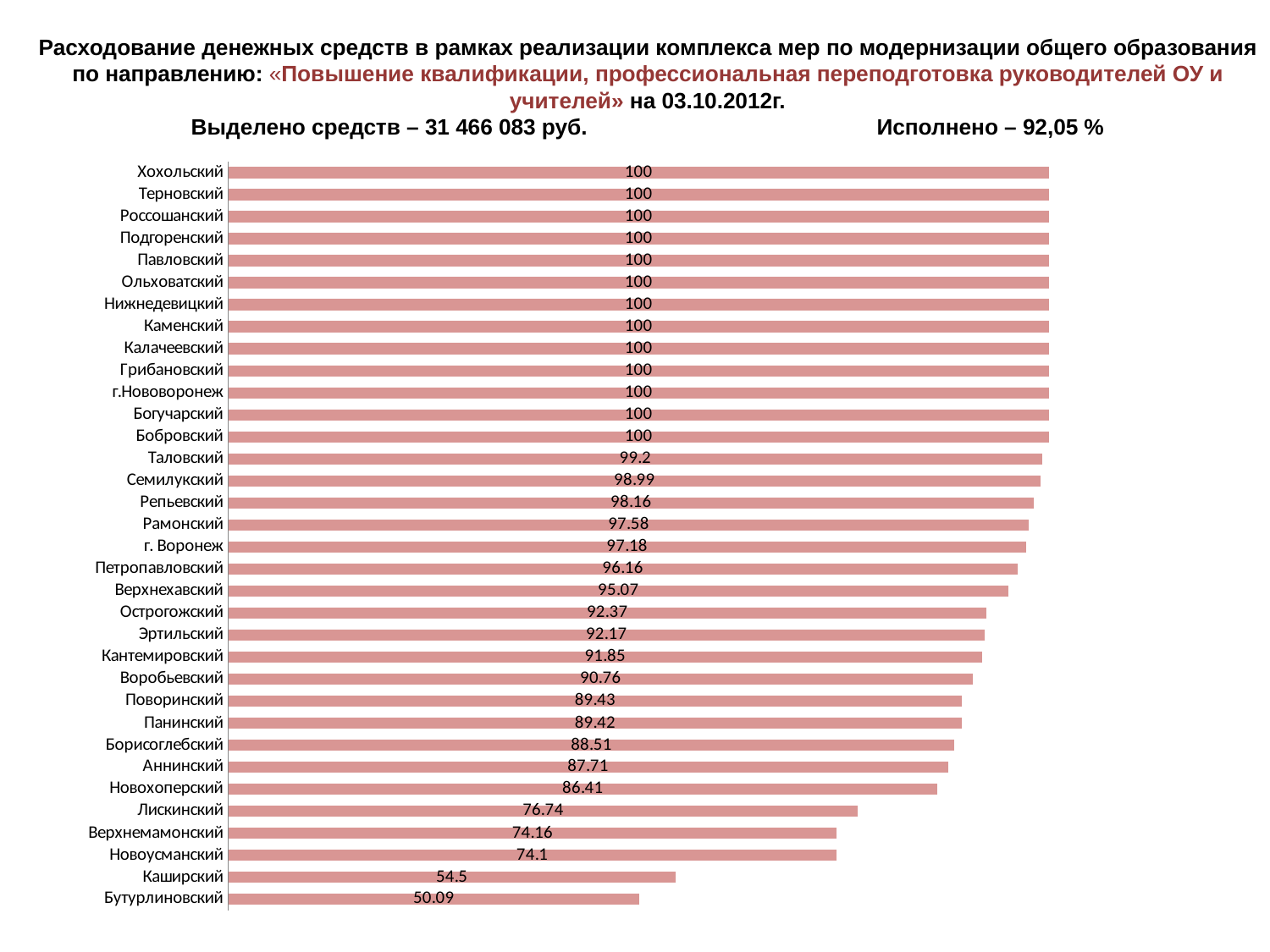
Which is larger, the value for Острогожский or the value for Воробьевский? Острогожский What kind of chart is shown on the slide? Bar chart How many categories have a value of 100? 13 What is the value for г. Воронеж? 97.18 What is the difference between the values for Таловский and Новохоперский? 12.79 What is the difference between the values for Каширский and Бутурлиновский? 4.41 Which is larger, the value for Верхнемамонский or the value for Лискинский? Лискинский What is the value for Лискинский? 76.74 What is the value for Бутурлиновский? 50.09 Which category has the lowest value? Бутурлиновский How many categories are shown in the chart? 34 What is the value for Каширский? 54.5